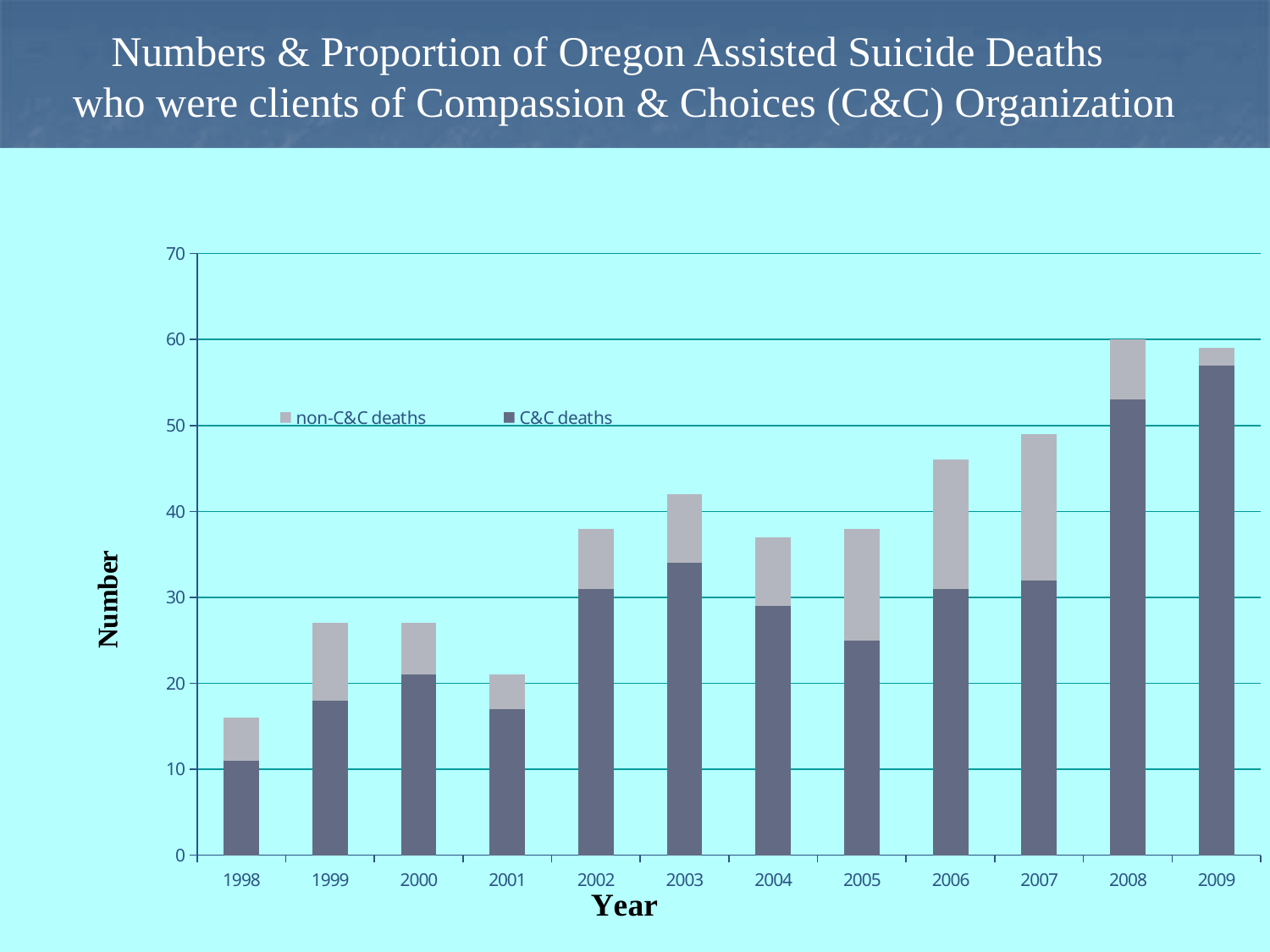
Which year has the larger total number of deaths, 2003 or 2004? 2003 How many years are shown along the x axis? 12 Is the number of C&C deaths for 2009 greater or less than 50? greater Overall, do the total numbers of deaths rise or fall from 1998 to 2009? rise What is the title of the vertical axis? Number How many series does the legend list? 2 Is the total number of deaths for 1998 greater or less than 20? less Is the number of C&C deaths for 2005 greater or less than 30? less Which year has the lowest total number of deaths? 1998 What kind of chart is shown on the slide? stacked bar chart